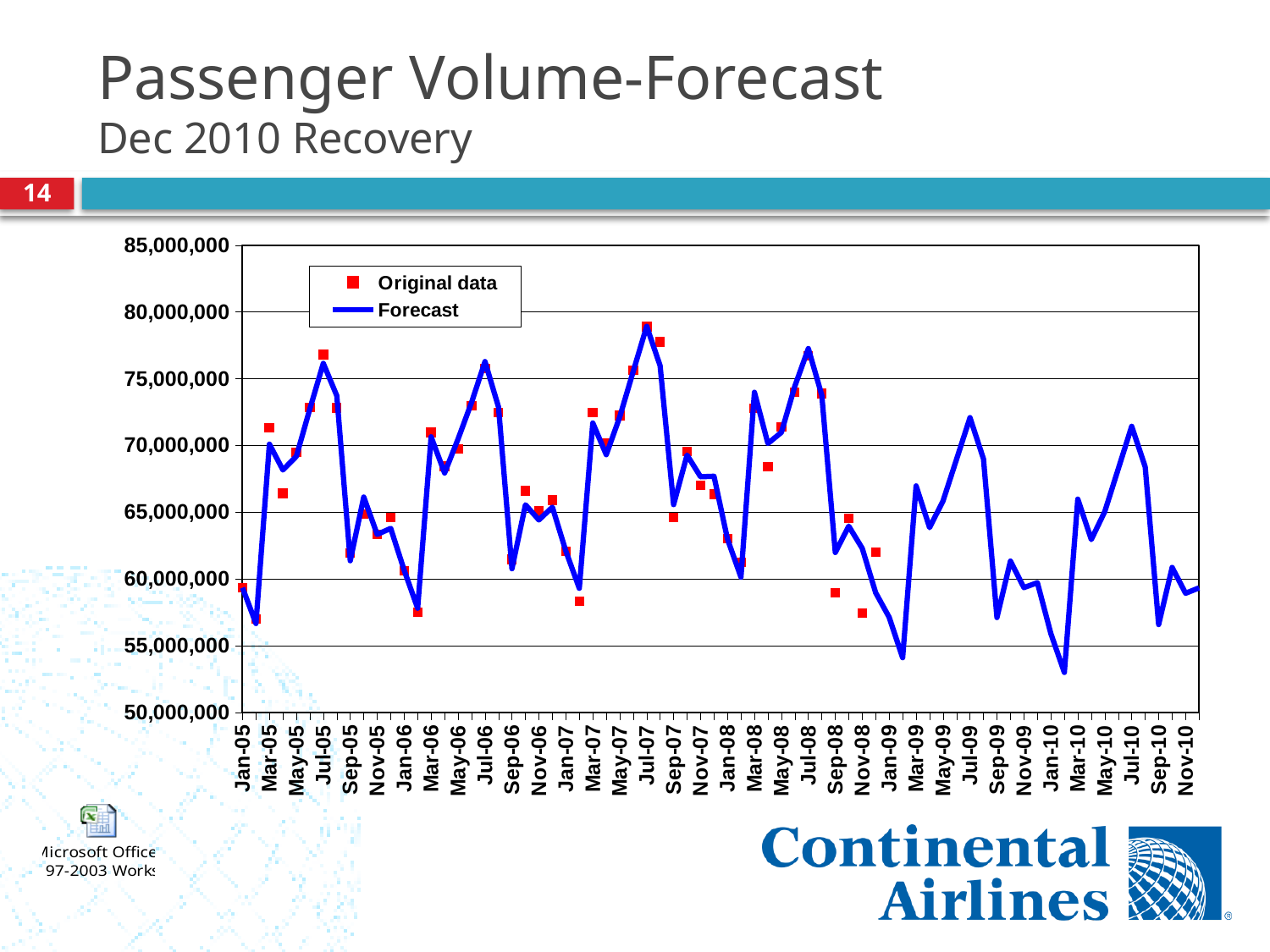
How many series does the legend list? 2 Does the Forecast line rise or fall from Jul-07 to Jan-08? Fall What is the highest value shown on the vertical axis? 85,000,000 At which month does the Forecast line reach its highest point? Jul-07 Is the Forecast value for Jul-09 greater or less than 70,000,000? greater What are the two series named in the legend? Original data and Forecast Which is larger, the Forecast value for Jul-07 or the Forecast value for Jul-06? Jul-07 Is the Original data value for Jul-05 greater or less than 75,000,000? greater Is the Forecast value for Jul-07 greater or less than 75,000,000? greater What kind of chart is shown on the slide? Line chart